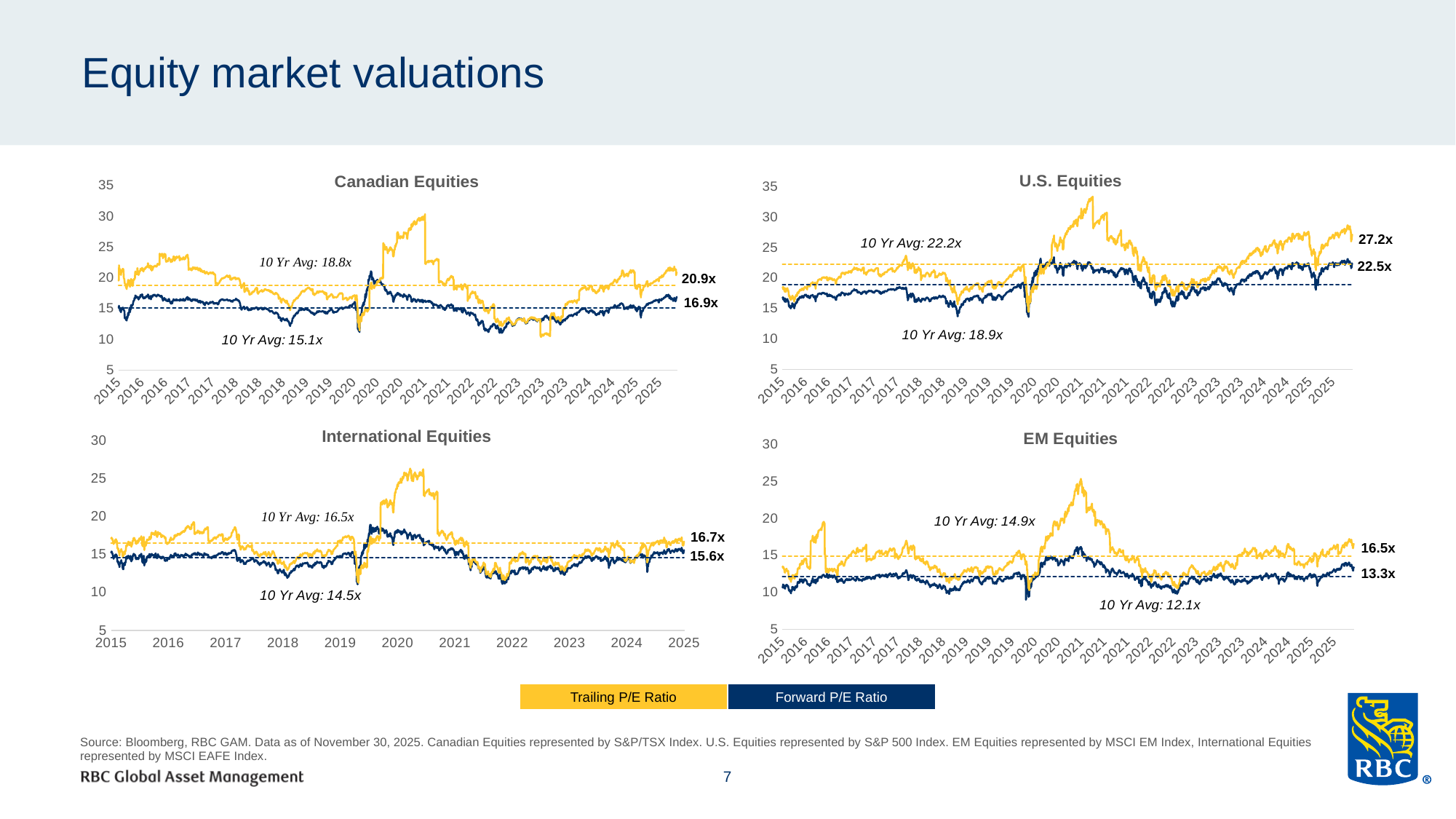
In the U.S. Equities chart, what is the difference between the latest trailing P/E (27.2x) and the latest forward P/E (22.5x)? 4.7x Which colour represents the Forward P/E Ratio in the legend? navy blue In the U.S. Equities chart, what is the latest forward P/E ratio value labelled at the end of the line? 22.5x In the International Equities chart, what is the 10-year average trailing P/E ratio shown? 16.5x In the EM Equities chart, how much higher is the latest trailing P/E (16.5x) than its 10-year average (14.9x)? 1.6x In the Canadian Equities chart, what is the latest trailing P/E ratio value labelled at the end of the line? 20.9x Across the four charts, which market has the highest latest trailing P/E ratio? U.S. Equities Across the four charts, which market has the lowest latest forward P/E ratio? EM Equities What type of chart is used for each of the four equity market panels? line chart In the EM Equities chart, what is the 10-year average forward P/E ratio shown? 12.1x In the Canadian Equities chart, is the latest forward P/E (16.9x) above or below its 10-year average of 15.1x? above How many series does the legend at the bottom of the slide list? 2